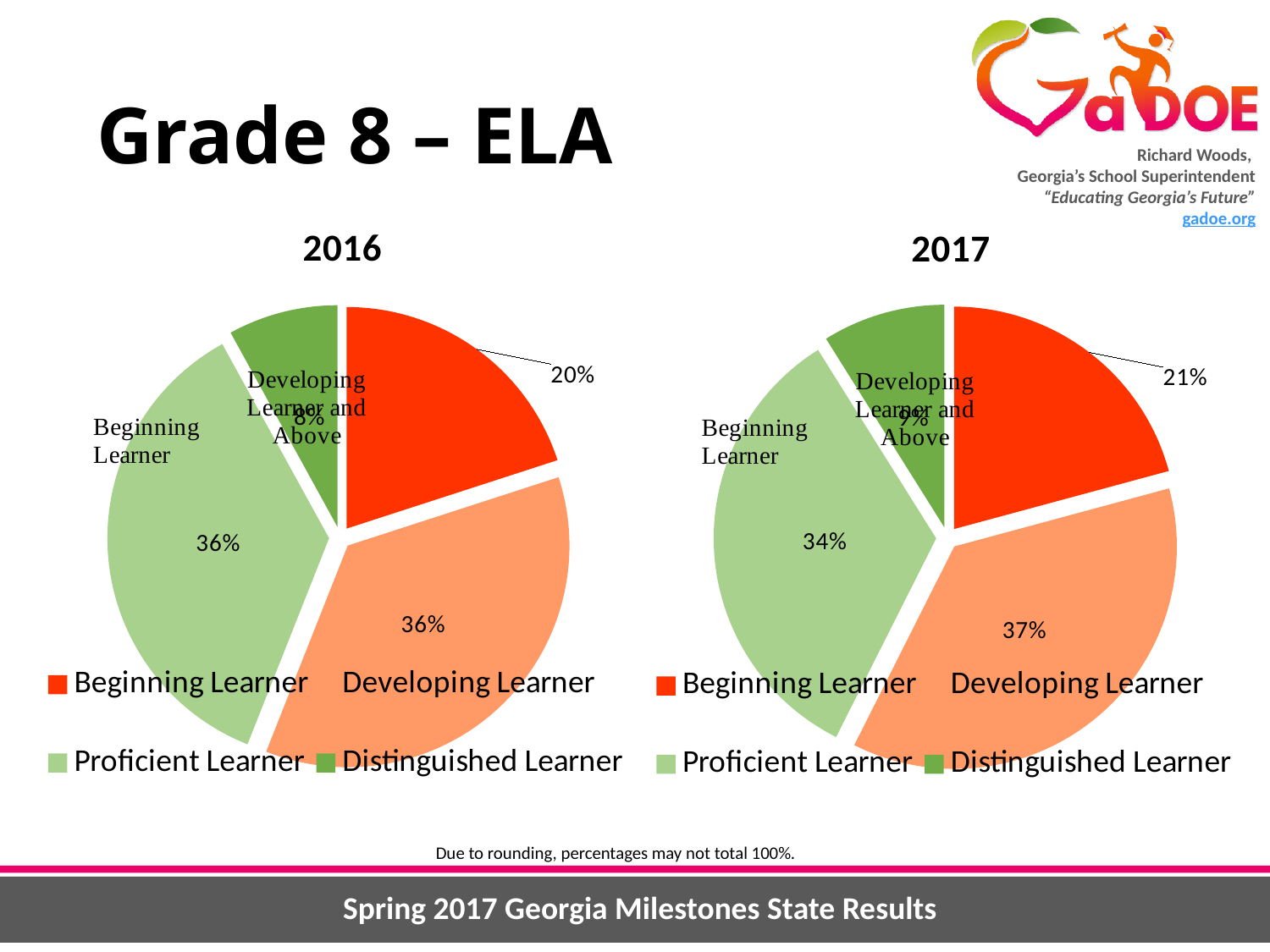
How many categories does the legend of the 2016 pie chart list? 4 In the 2016 pie chart, which category has the smallest slice? Distinguished Learner In the 2016 pie chart, what percentage is shown for the Developing Learner slice? 36% In the 2017 pie chart, what percentage is shown for the Developing Learner slice? 37% In the 2017 pie chart, what is the difference in percentage points between the Developing Learner and Proficient Learner slices? 3 What colour is the Beginning Learner slice in the 2016 pie chart? Red What type of chart is used to show the 2017 results? Pie chart In the 2017 pie chart, which category has the largest slice? Developing Learner In the 2016 pie chart, what percentage is shown for the Beginning Learner slice? 20% In the 2017 pie chart, which category has the smallest slice? Distinguished Learner Is the Beginning Learner percentage larger in the 2016 chart or the 2017 chart? 2017 In the 2017 pie chart, what percentage is shown for the Proficient Learner slice? 34%